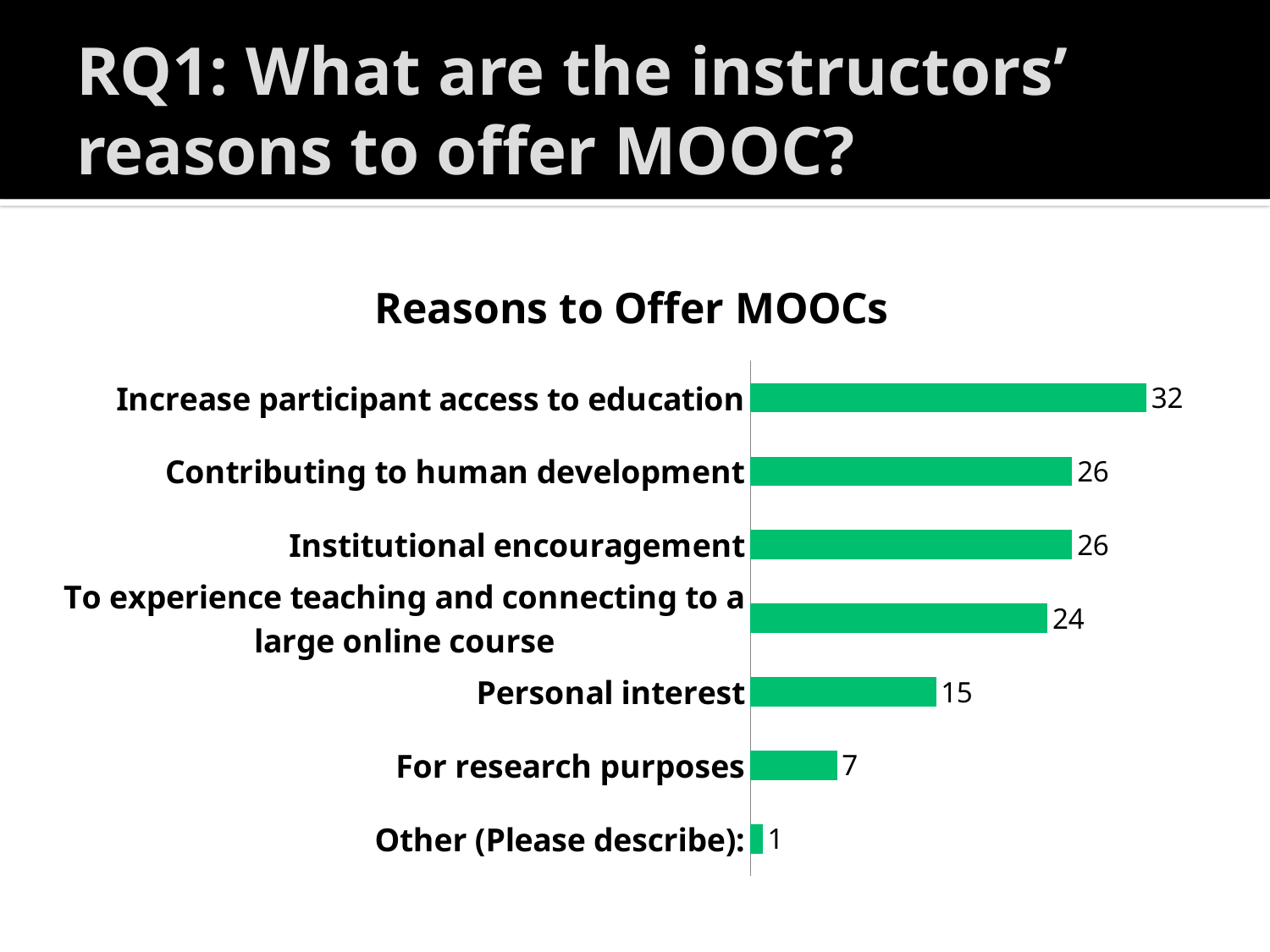
What is the value for "Increase participant access to education"? 32 What kind of chart is shown on the slide? Bar chart What is the difference between the values for "Increase participant access to education" and "Contributing to human development"? 6 Which is larger, the value for "Institutional encouragement" or the value for "Personal interest"? Institutional encouragement What is the title of the chart? Reasons to Offer MOOCs How many reasons (categories) are shown in the chart? 7 What is the value for "To experience teaching and connecting to a large online course"? 24 What is the value for "Personal interest"? 15 What is the difference between the values for "Personal interest" and "For research purposes"? 8 Which reason has the highest value? Increase participant access to education What is the value for "For research purposes"? 7 Which reason has the lowest value? Other (Please describe):